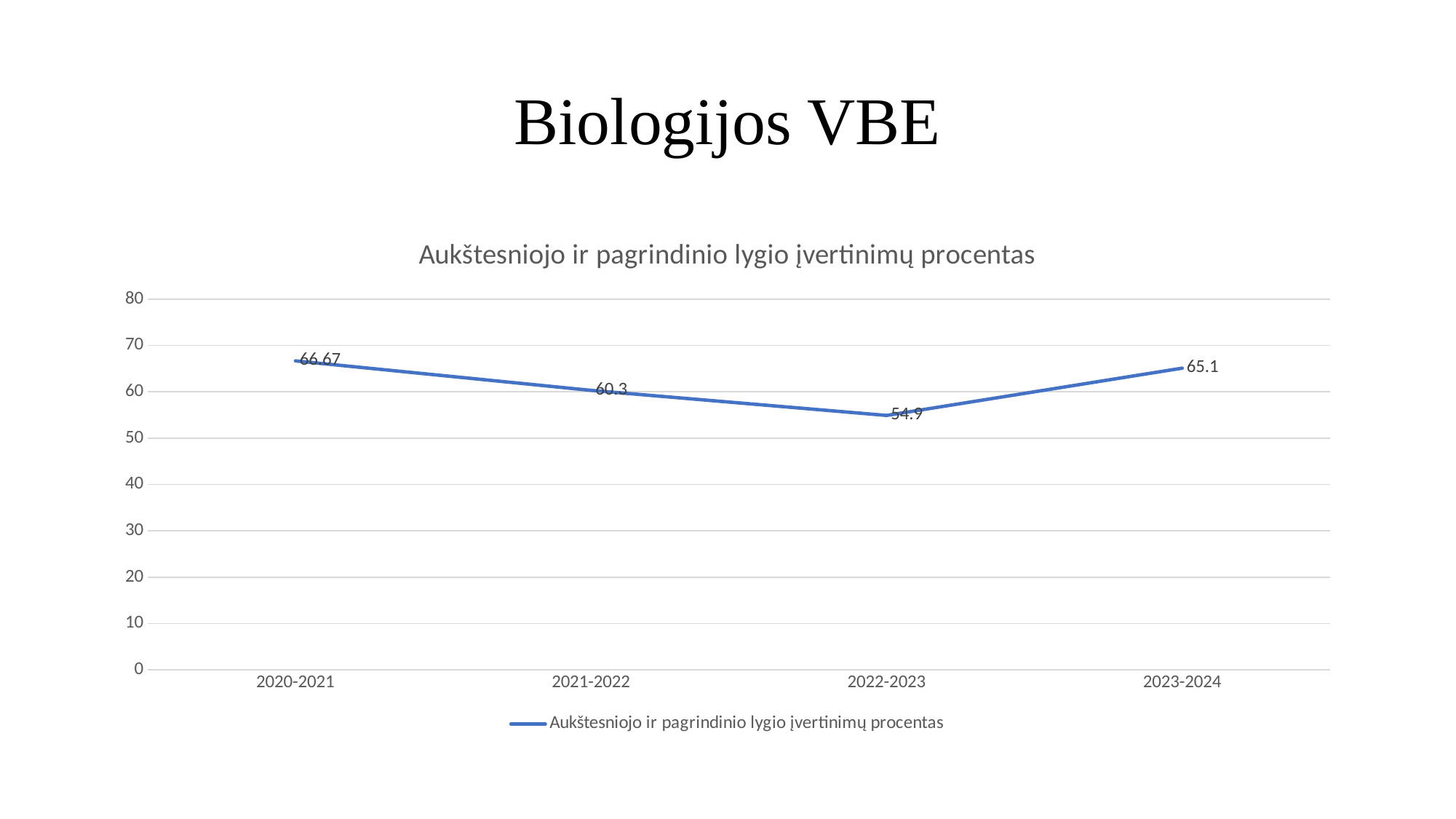
How many school years are plotted on the chart? 4 What is the title of the chart? Aukštesniojo ir pagrindinio lygio įvertinimų procentas What is the value for 2022-2023? 54.9 Is the value for 2022-2023 greater or less than 60? less What is the difference between the values for 2020-2021 and 2022-2023? 11.77 What is the value for 2020-2021? 66.67 What kind of chart is shown on the slide? line chart Which school year has the lowest value? 2022-2023 Which is larger, the value for 2021-2022 or the value for 2023-2024? 2023-2024 What is the value for 2021-2022? 60.3 Which school year has the highest value? 2020-2021 What is the value for 2023-2024? 65.1